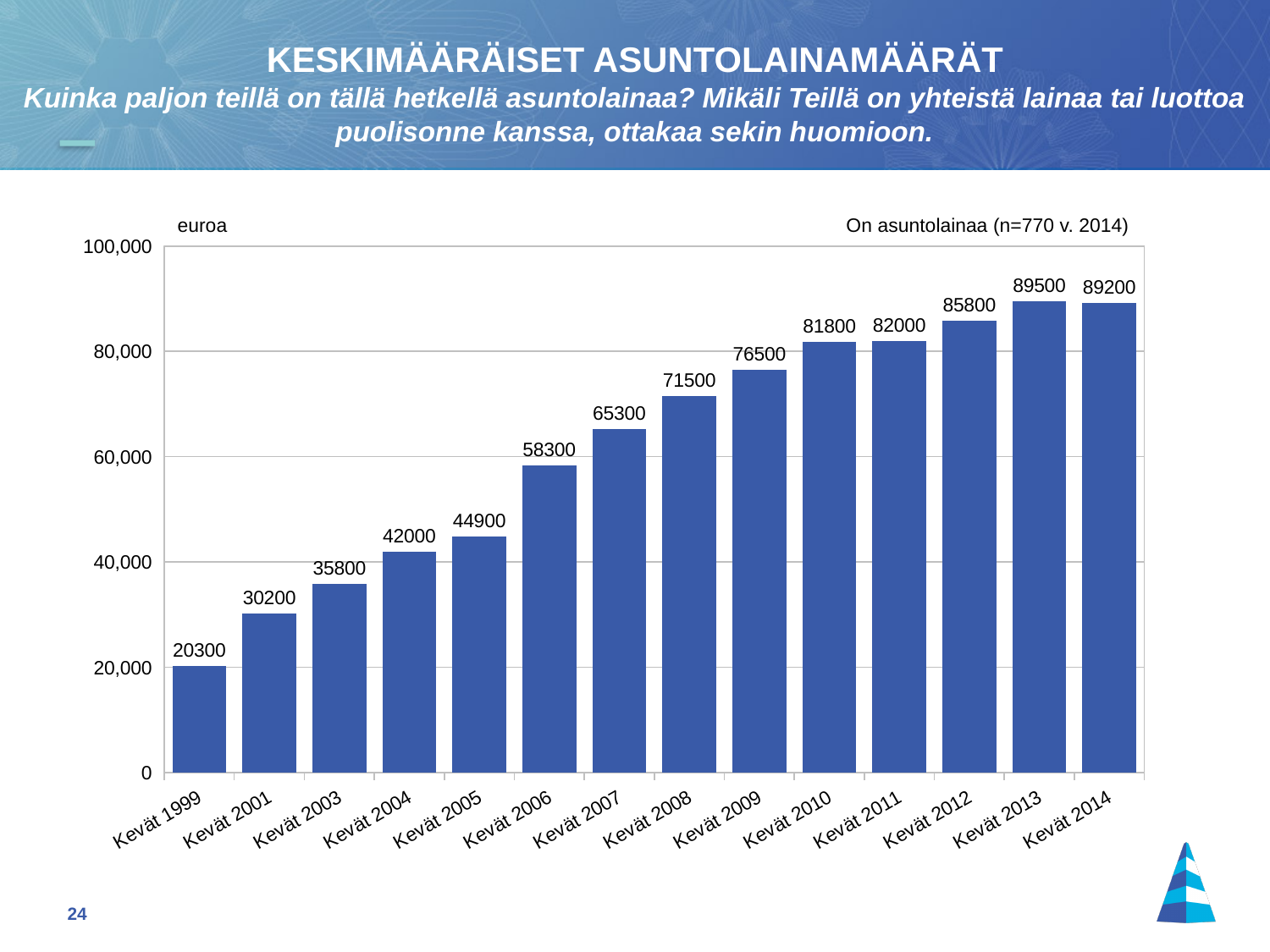
Which category has the highest value? Kevät 2013 What value is shown for Kevät 1999? 20300 Which is larger, the value for Kevät 2005 or Kevät 2006? Kevät 2006 What kind of chart is shown on the slide? bar chart Which category has the lowest value? Kevät 1999 How many categories are shown on the x axis? 14 What is the value for Kevät 2012? 85800 What is the average housing loan amount for Kevät 2007? 65300 What is the difference between the values for Kevät 2014 and Kevät 1999? 68900 Is the value for Kevät 2009 greater or less than 80,000? less Do the values generally rise or fall from Kevät 1999 to Kevät 2013? rise What is the difference between the values for Kevät 2011 and Kevät 2010? 200